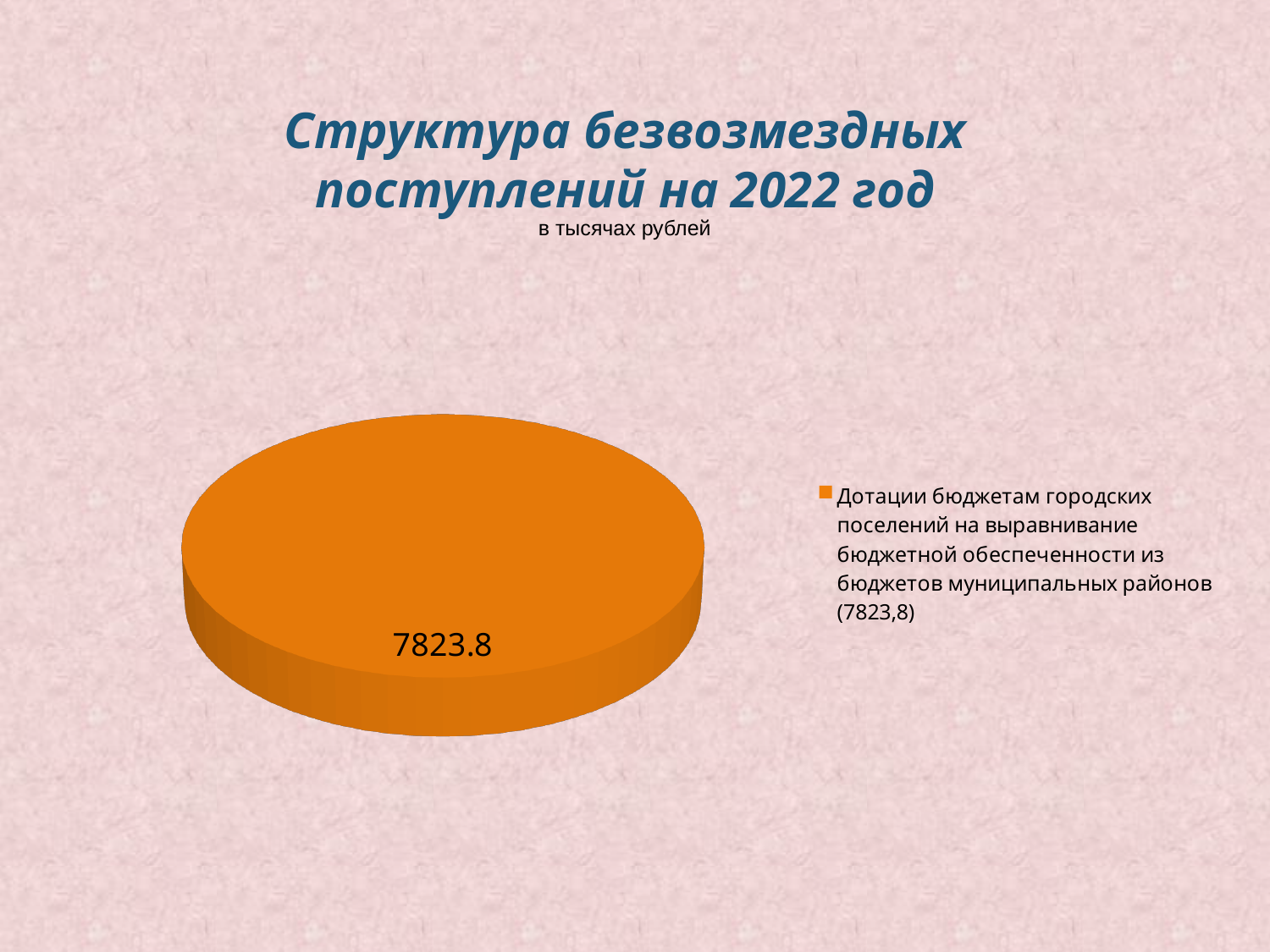
How many entries does the legend of the pie chart list? 1 Which category is the largest in the pie chart? Дотации бюджетам городских поселений на выравнивание бюджетной обеспеченности из бюджетов муниципальных районов What kind of chart is shown on the slide? pie chart In what units are the values on the chart given, according to the subtitle? в тысячах рублей Is the value shown on the pie chart greater or less than 7000? greater What is the title of the chart on the slide? Структура безвозмездных поступлений на 2022 год How many slices does the pie chart have? 1 What value is shown on the pie chart for 'Дотации бюджетам городских поселений на выравнивание бюджетной обеспеченности из бюджетов муниципальных районов'? 7823.8 What share of the pie does the slice for 'Дотации бюджетам городских поселений на выравнивание бюджетной обеспеченности из бюджетов муниципальных районов' represent? 100%